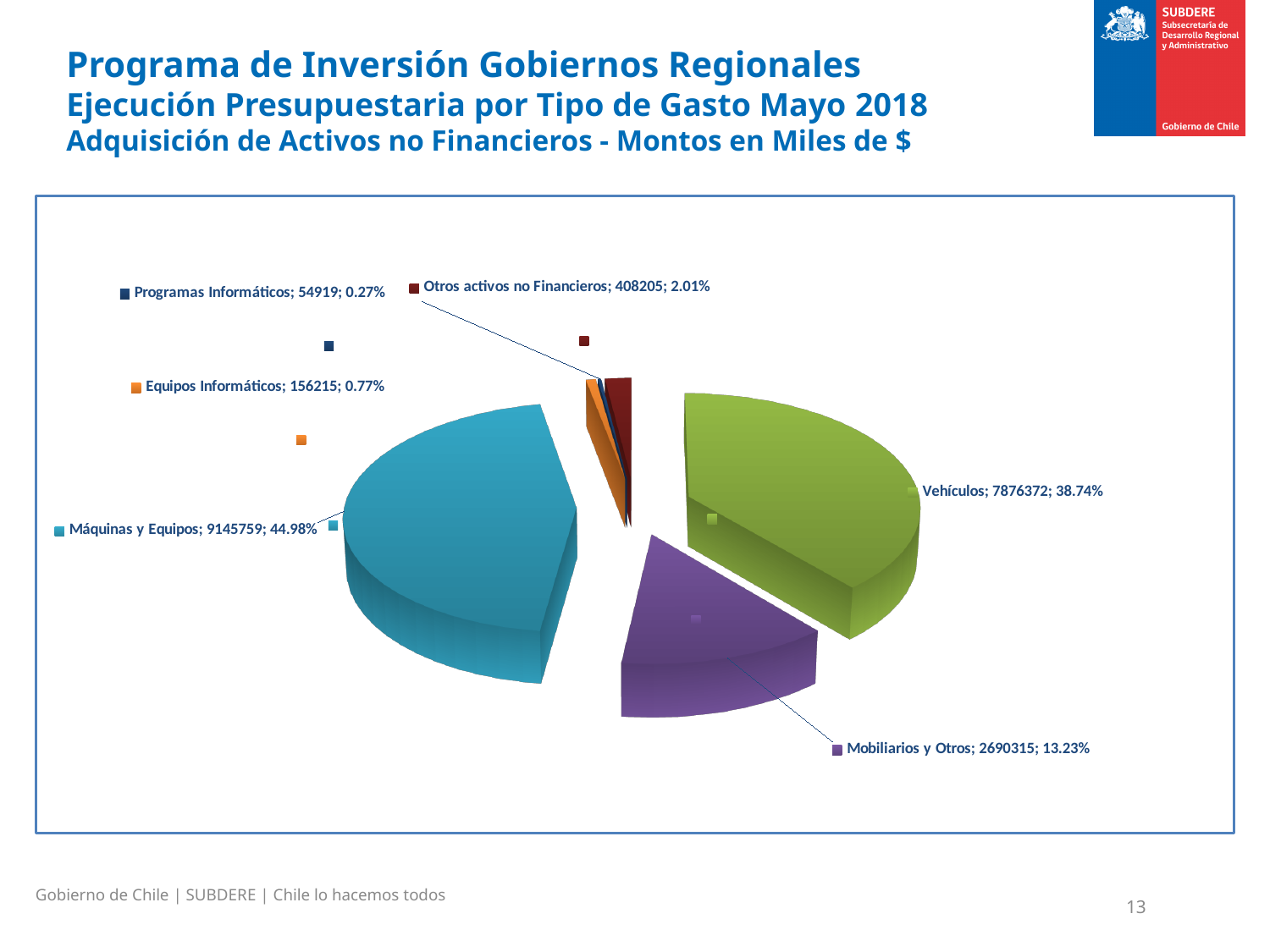
What is the percentage share of Equipos Informáticos? 0.77% What is the difference between the values for Máquinas y Equipos and Vehículos? 1269387 What is the difference between the values for Equipos Informáticos and Programas Informáticos? 101296 Which category has the largest slice of the pie? Máquinas y Equipos What percentage share does Vehículos have in the pie chart? 38.74% How many categories are shown in the pie chart? 6 What is the value for Mobiliarios y Otros? 2690315 What is the value for Máquinas y Equipos? 9145759 Which is larger, the value for Vehículos or the value for Mobiliarios y Otros? Vehículos Which category has the smallest slice of the pie? Programas Informáticos What percentage share does Otros activos no Financieros have? 2.01% What kind of chart is shown on the slide? Pie chart